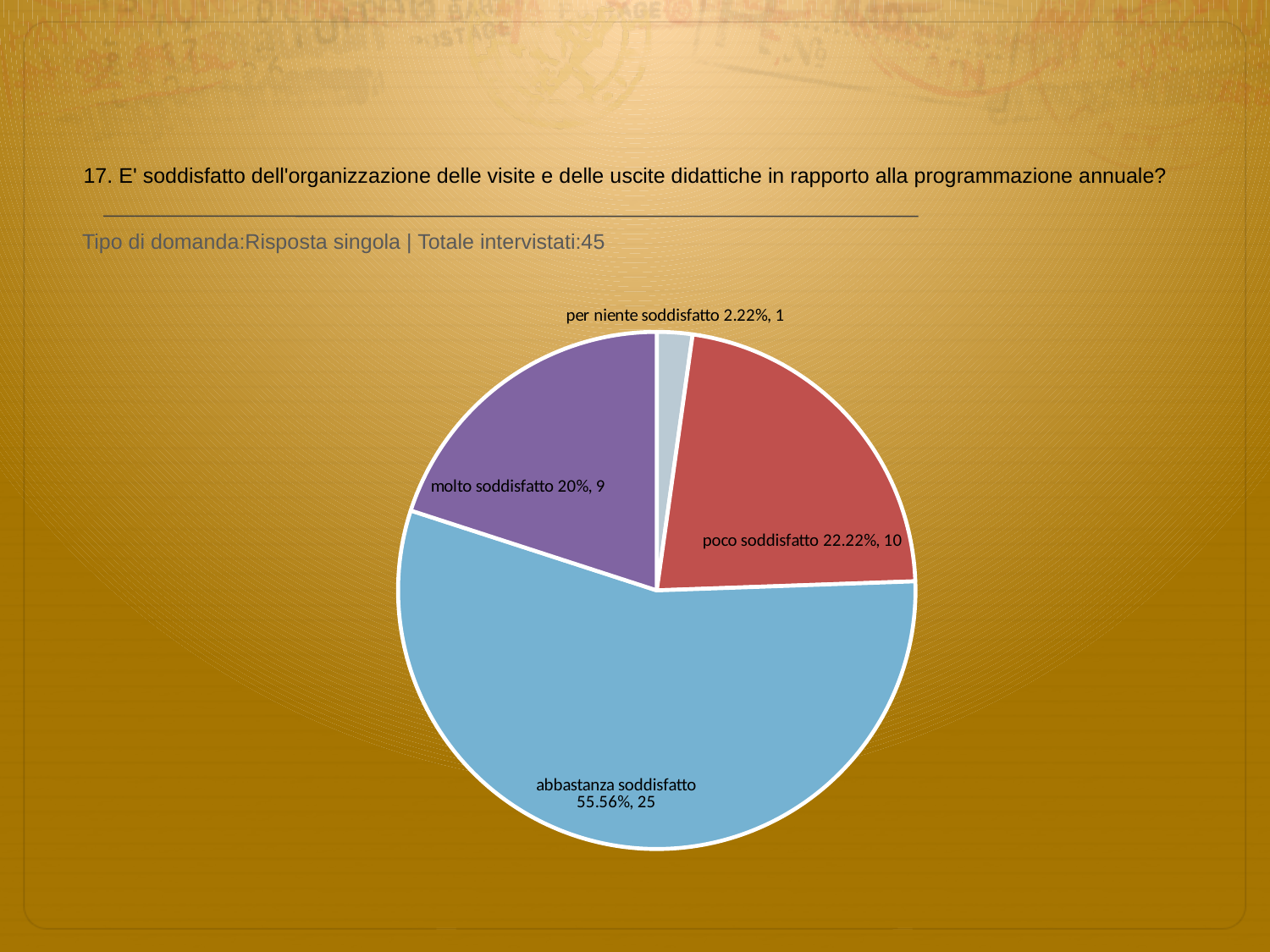
Which category has the largest slice of the pie? abbastanza soddisfatto How many slices does the pie chart have? 4 What kind of chart is shown on the slide? pie chart What percentage is shown for "abbastanza soddisfatto"? 55.56% Which has more respondents, "poco soddisfatto" or "molto soddisfatto"? poco soddisfatto How many respondents answered "poco soddisfatto"? 10 Which category has the smallest slice of the pie? per niente soddisfatto What colour is the "abbastanza soddisfatto" slice? blue What is the difference in respondent count between "abbastanza soddisfatto" and "molto soddisfatto"? 16 What is the total number of respondents shown in the subtitle? 45 What percentage is shown for "molto soddisfatto"? 20% How many respondents answered "per niente soddisfatto"? 1